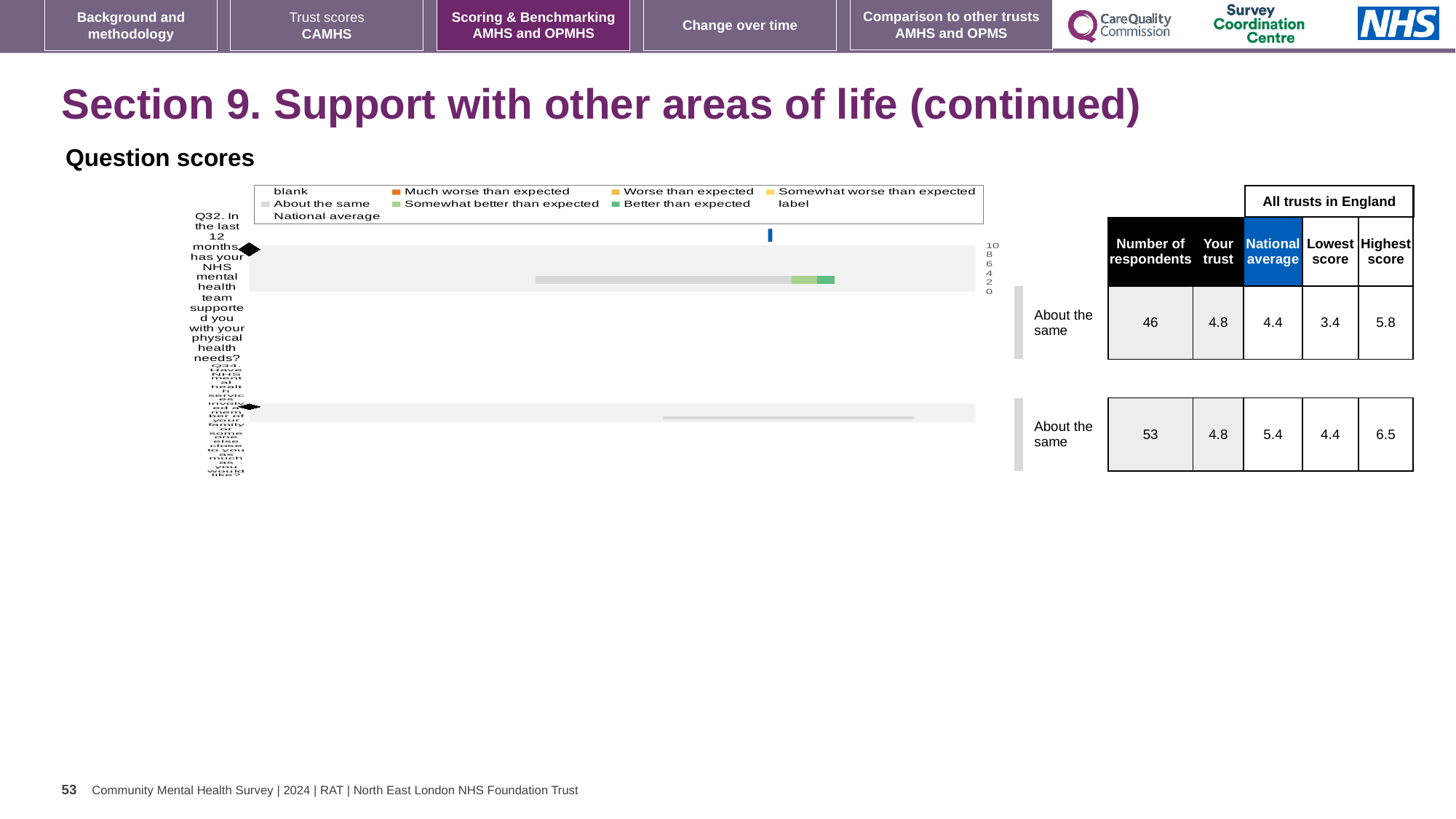
What is the highest value shown on the chart's numeric axis? 10 What is the lowest score across all trusts in England for Q32? 3.4 What is the national average score for Q32? 4.4 For Q34, which is larger: the trust's score or the national average? national average Which question has more respondents, Q32 or Q34? Q34 What kind of chart is shown on the slide? bar chart How many respondents are listed for Q32 in the table beside the chart? 46 What is the highest score across all trusts in England for Q34? 6.5 What is the difference between the highest and lowest scores for Q32? 2.4 What is the 'Your trust' score for Q34? 4.8 What colour does the legend use for 'Much worse than expected'? orange How many survey questions are plotted as bars in the chart? 2